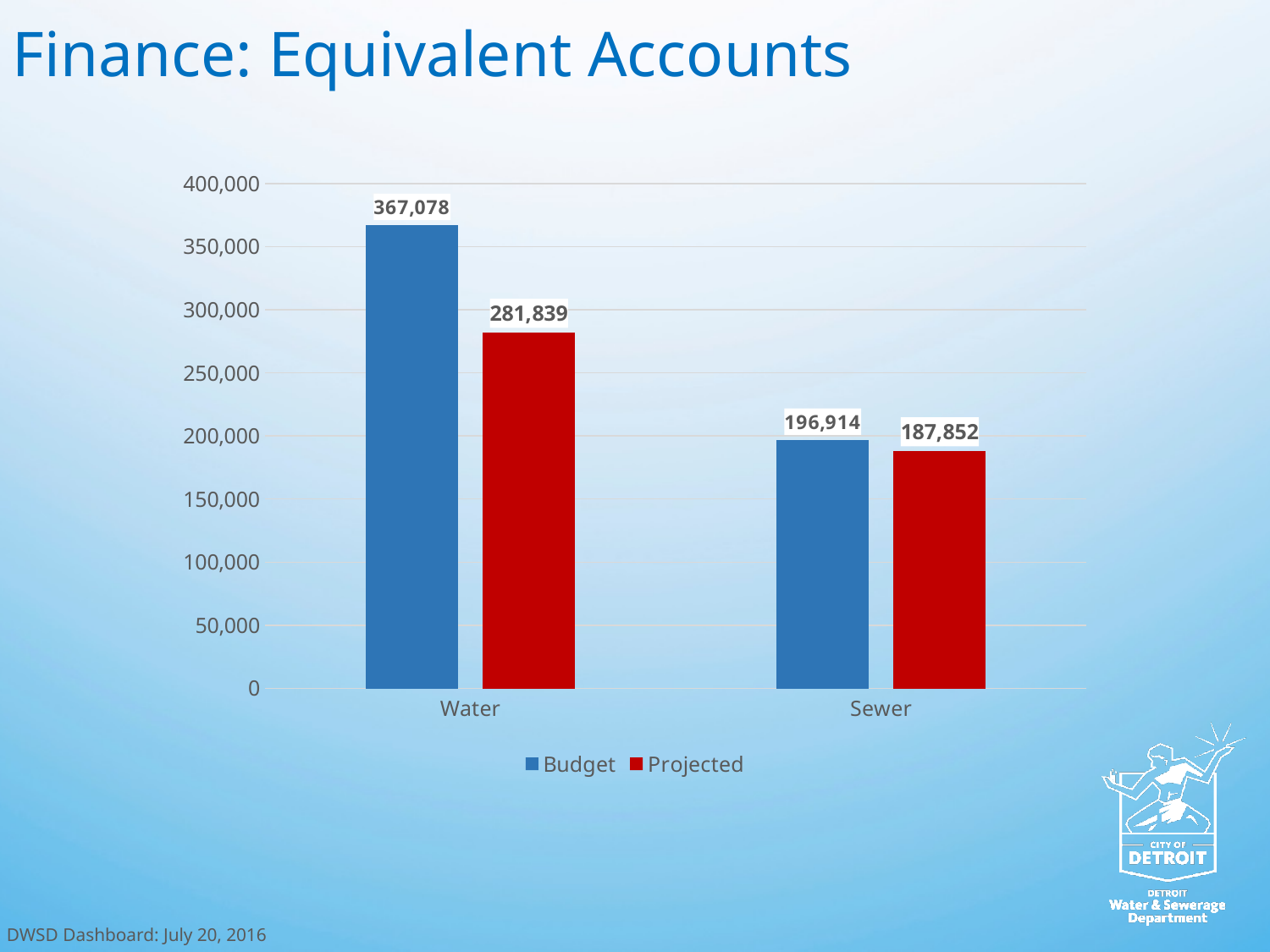
How many categories are shown on the x axis? 2 What is the Budget value for Water? 367,078 What is the Projected value for Water? 281,839 Which category has the lowest Projected value? Sewer Which is larger for Sewer, the Budget value or the Projected value? Budget Is the Projected value for Water greater or less than 300,000? less How many series does the legend list? 2 What is the difference between the Budget and Projected values for Water? 85,239 What kind of chart is shown on the slide? bar chart What is the Projected value for Sewer? 187,852 Which category has the highest Budget value? Water What is the difference between the Budget and Projected values for Sewer? 9,062